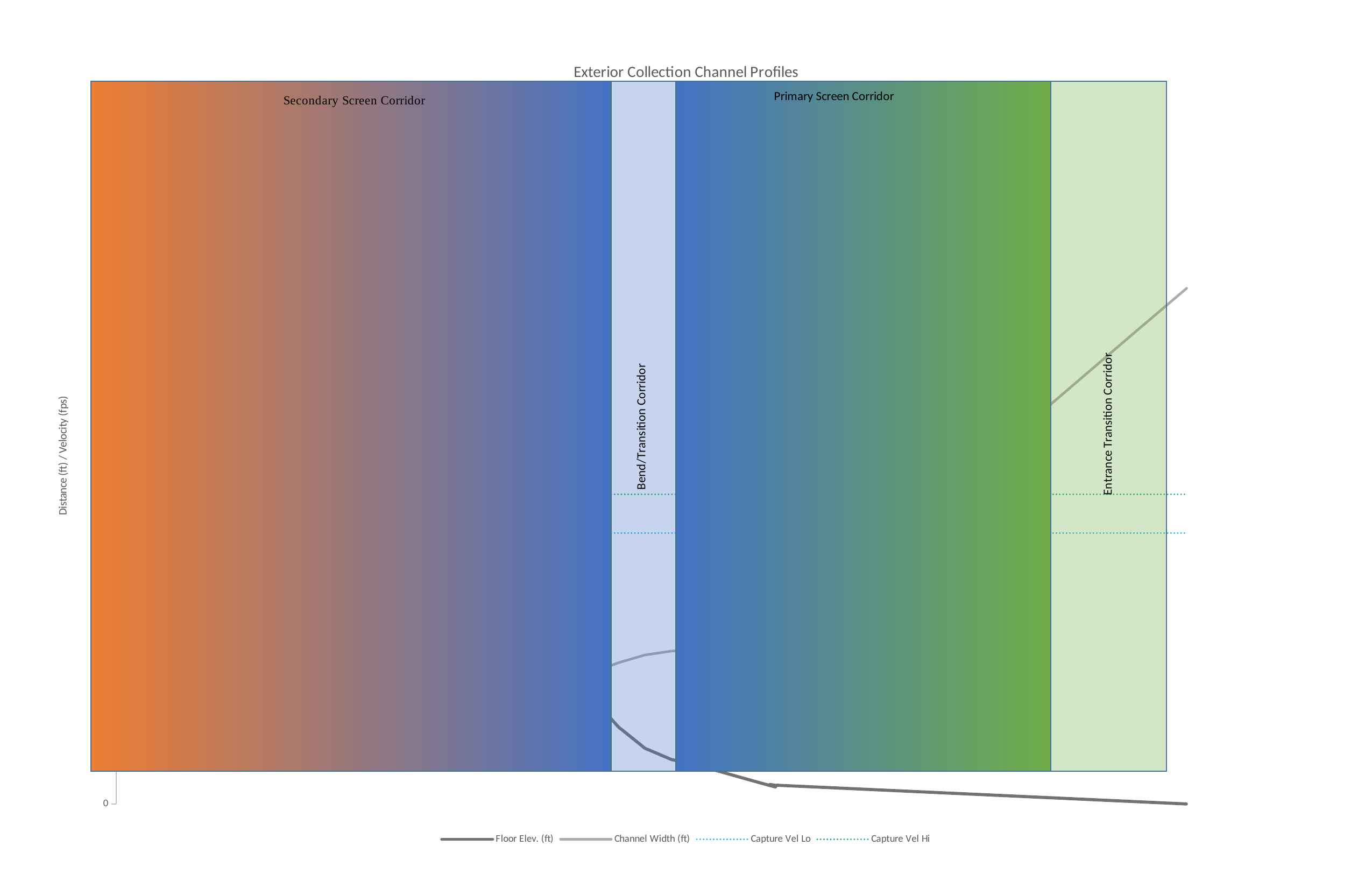
Which series is plotted higher on the chart, Capture Vel Lo or Capture Vel Hi? Capture Vel Hi How many series does the chart legend list? 4 Does the Channel Width (ft) line rise or fall moving left to right across the Entrance Transition Corridor? rise What kind of chart is shown on the slide? line chart Which legend series is drawn with a dotted green line? Capture Vel Hi What is the label on the vertical axis of the chart? Distance (ft) / Velocity (fps) What is the title of the chart? Exterior Collection Channel Profiles Does the Floor Elev. (ft) line rise or fall moving left to right across the Primary Screen Corridor? fall